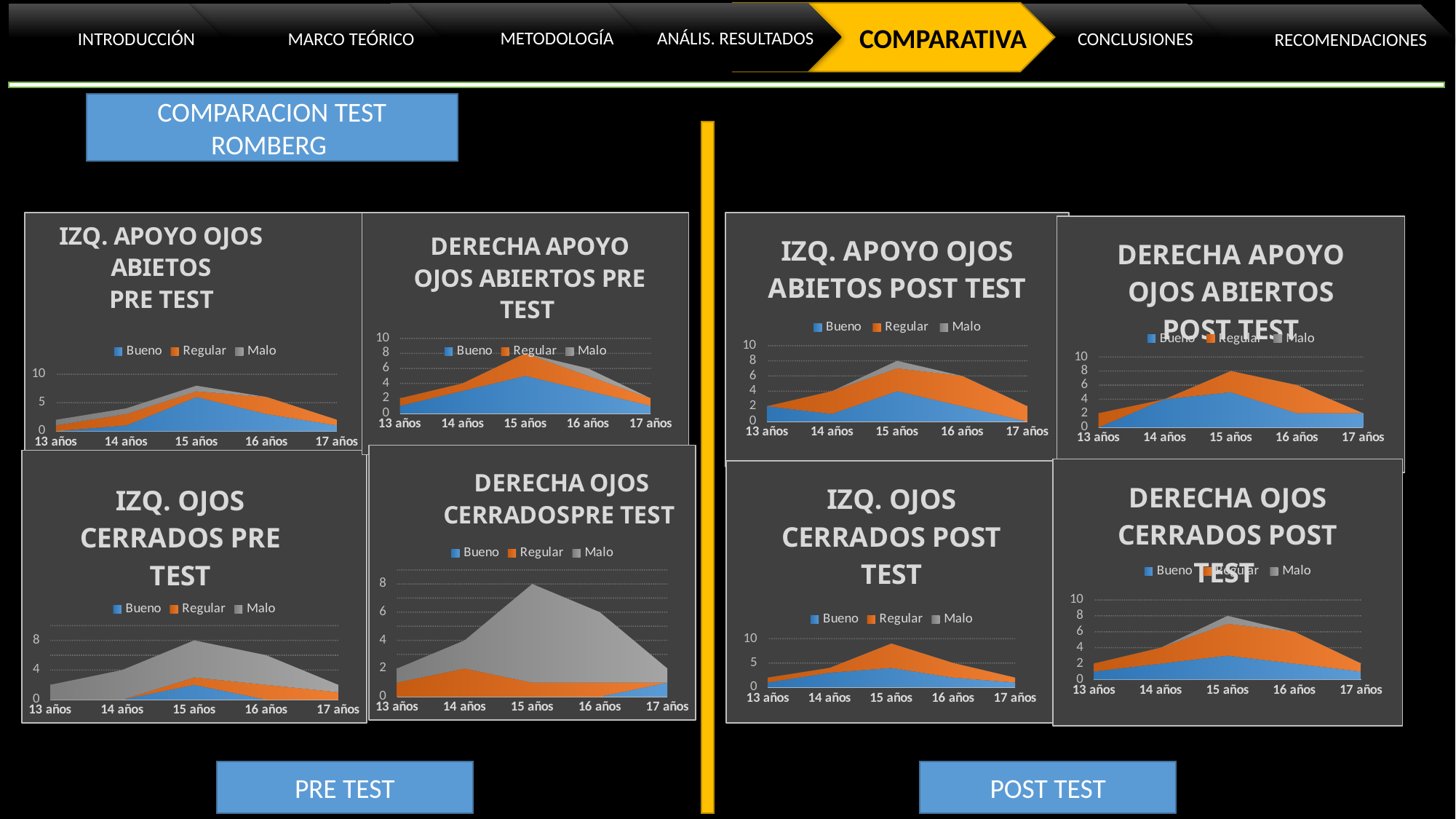
How many age categories are shown on the x axis of the "DERECHA APOYO OJOS ABIERTOS PRE TEST" chart? 5 In the "DERECHA OJOS CERRADOSPRE TEST" chart, is the stacked total at 15 años greater or less than 4? greater In the "DERECHA OJOS CERRADOSPRE TEST" chart, at which age category does the stacked total reach its highest point? 15 años In the "IZQ. OJOS CERRADOS POST TEST" chart, is the stacked total at 15 años greater or less than 5? greater In the "IZQ. APOYO OJOS ABIETOS PRE TEST" chart, is the stacked total at 13 años greater or less than 5? less In the "IZQ. OJOS CERRADOS POST TEST" chart, at which age category does the stacked total peak? 15 años What are the legend entries in the "IZQ. OJOS CERRADOS POST TEST" chart? Bueno, Regular, Malo What kind of chart is the "IZQ. APOYO OJOS ABIETOS PRE TEST" chart? Area chart In the "DERECHA APOYO OJOS ABIERTOS POST TEST" chart, does the stacked total rise or fall from 15 años to 17 años? fall In the "DERECHA OJOS CERRADOSPRE TEST" chart, which series occupies the largest area? Malo How many series does the legend list in the "DERECHA OJOS CERRADOSPRE TEST" chart? 3